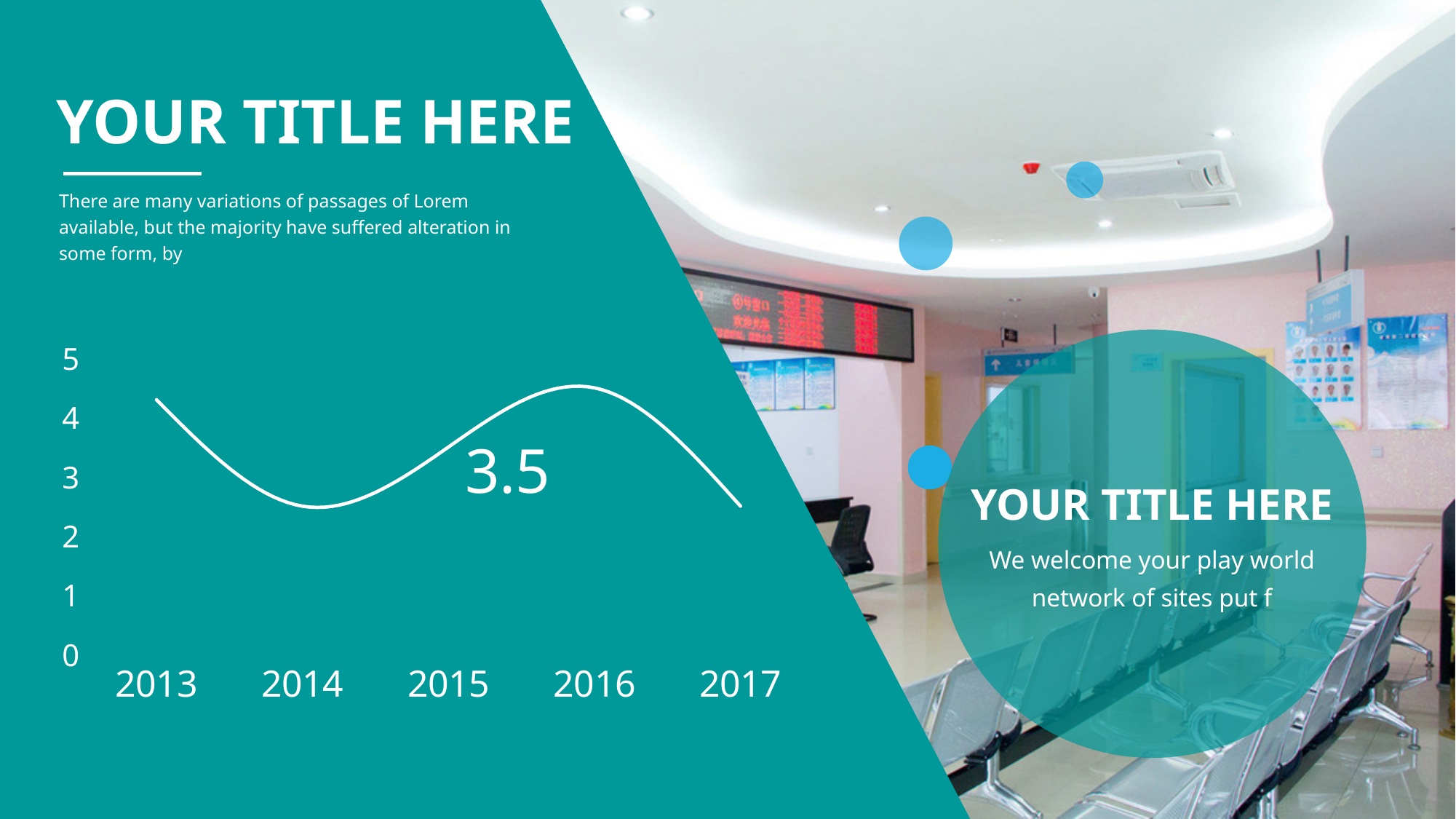
What kind of chart is shown on the slide? line chart Does the line rise or fall from 2014 to 2016? rise Is the value for 2016 greater or less than 4? greater How many years are shown on the x axis of the chart? 5 Which is larger, the value for 2013 or the value for 2014? 2013 Is the value for 2013 greater or less than 3? greater What value is labelled on the chart for 2015? 3.5 Is the value for 2014 greater or less than 3? less Which year has the highest value on the chart? 2016 Does the line rise or fall from 2013 to 2014? fall What is the highest value shown on the y axis of the chart? 5